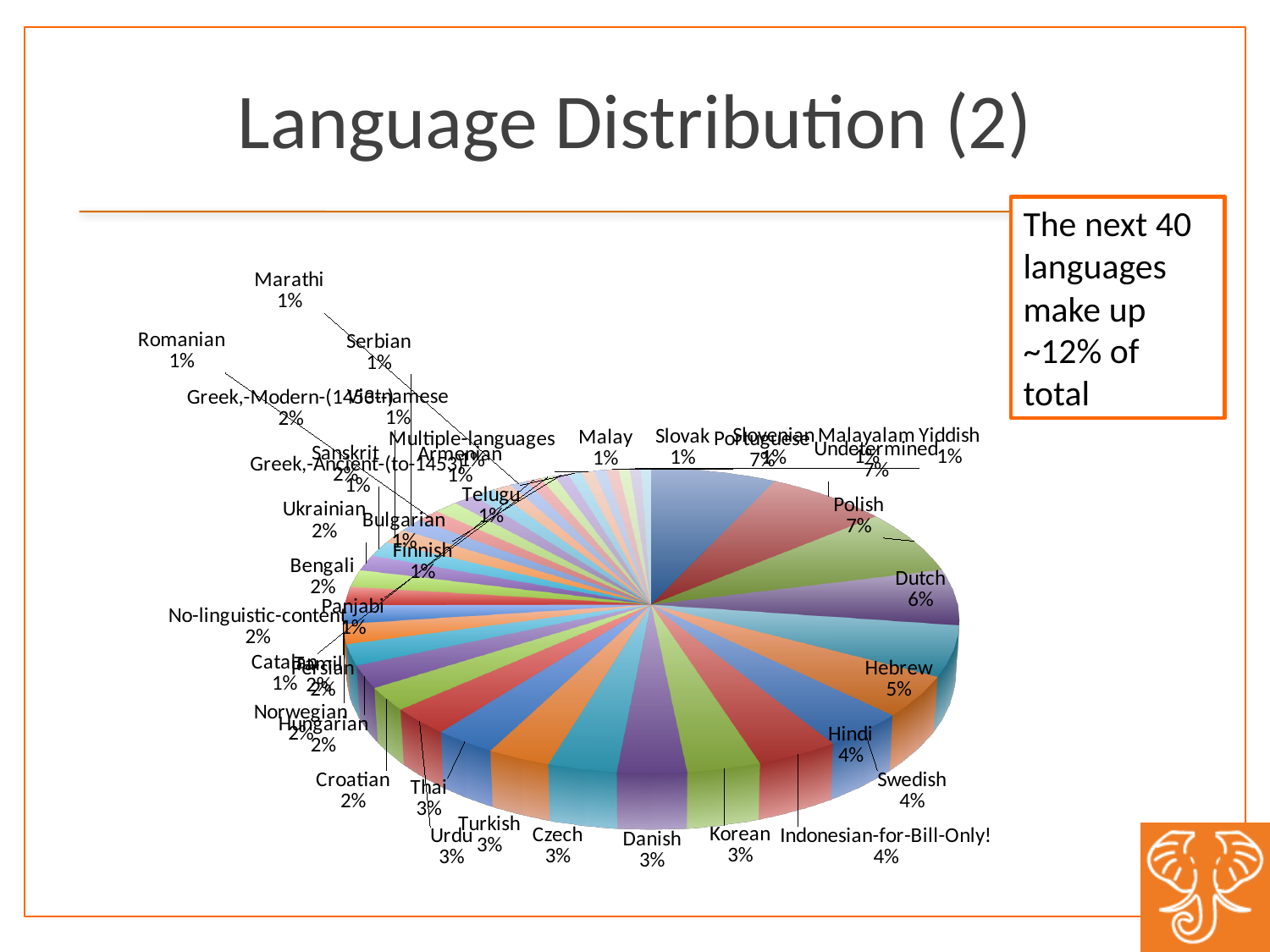
What is the title of the slide containing the chart? Language Distribution (2) Which is larger, the slice for Polish or the slice for Dutch? Polish What kind of chart is shown on the slide? pie chart What is the value shown for Hebrew? 5% What is the value shown for Hindi? 4% What is the value shown for Marathi? 1% What is the value shown for Croatian? 2% What is the difference between the values for Polish and Hebrew? 2% Which is larger, the slice for Hebrew or the slice for Swedish? Hebrew What is the value shown for Korean? 3% What share of the pie does Dutch have? 6% What share of the pie does Polish have? 7%